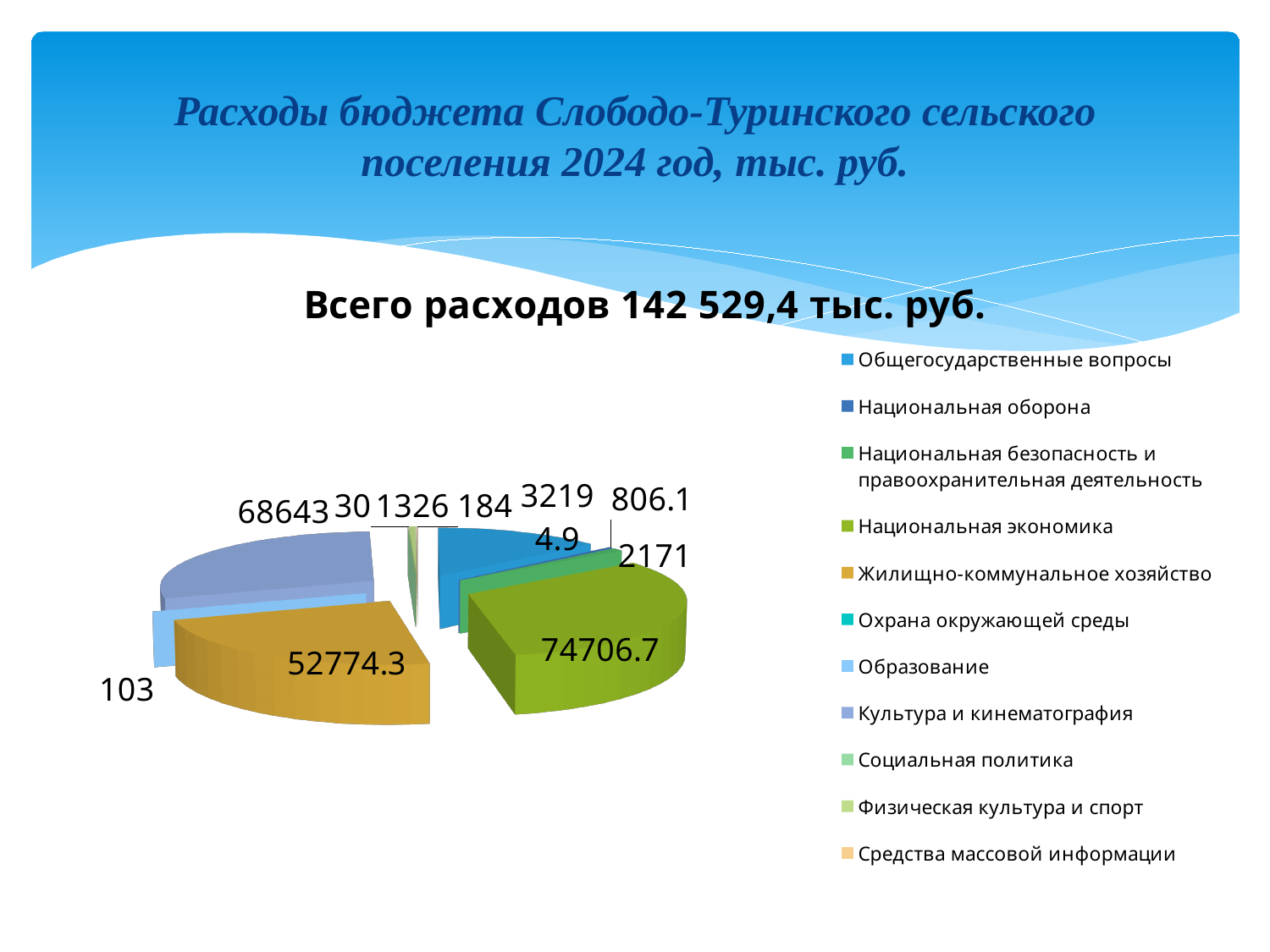
What is the value shown for Жилищно-коммунальное хозяйство? 52774.3 What kind of chart is shown on the slide? Pie chart What is the value shown for Национальная экономика? 74706.7 What total expenditure is stated in the chart title? 142 529,4 тыс. руб. Which category has the largest slice in the pie chart? Национальная экономика What is the smallest data label printed on the pie chart? 30 What colour is the slice for Национальная экономика? Green Which is larger: Национальная экономика or Жилищно-коммунальное хозяйство? Национальная экономика Which category has the second largest slice in the pie chart? Культура и кинематография How many categories does the legend of the pie chart list? 11 What is the difference between the values for Национальная экономика and Жилищно-коммунальное хозяйство? 21932.4